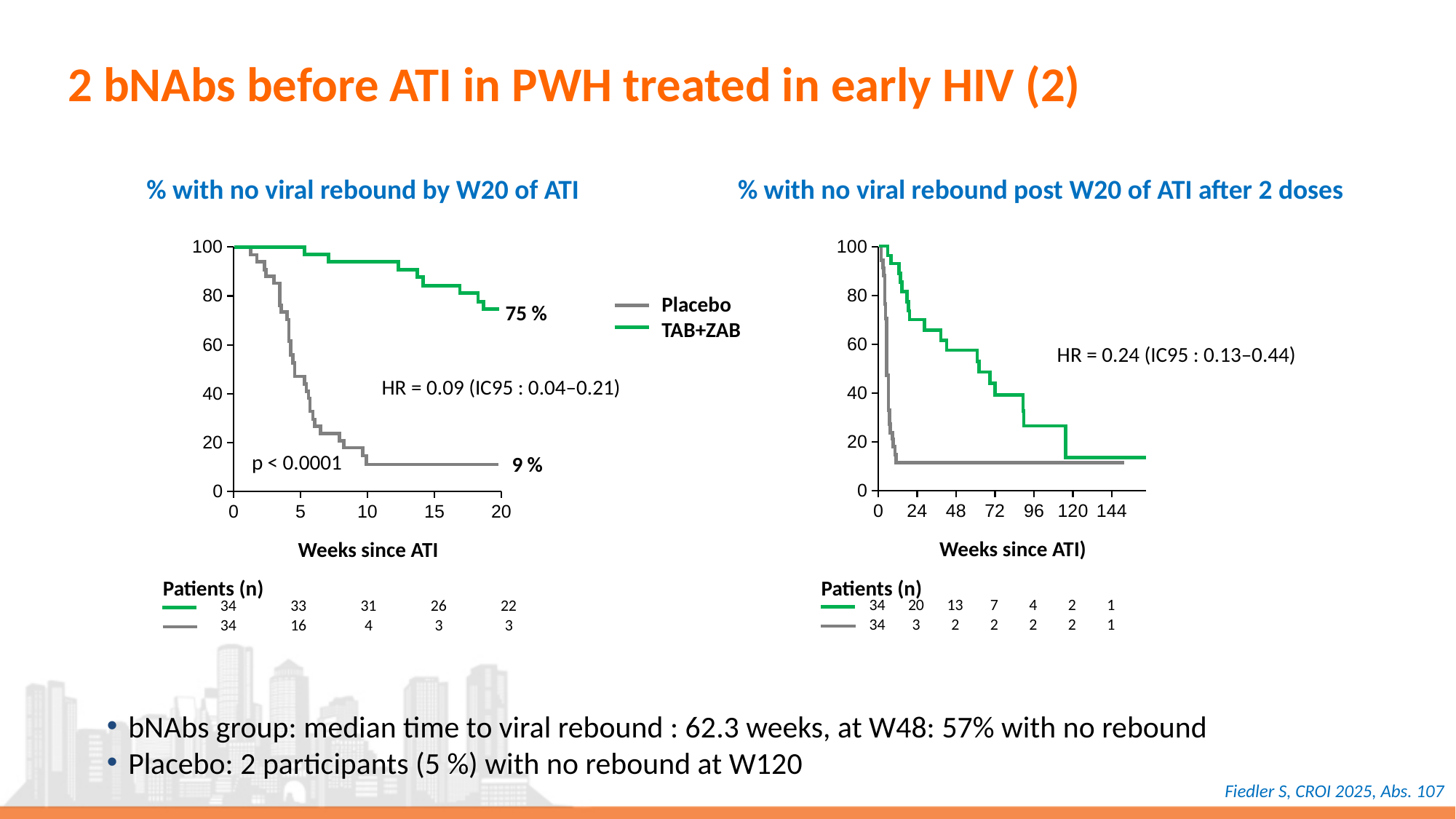
In the right chart (% with no viral rebound post W20 of ATI after 2 doses), is the Placebo value at week 24 greater or less than 20? less In the left chart (% with no viral rebound by W20 of ATI), which group has the higher percentage with no viral rebound at week 20? TAB+ZAB In the left chart (% with no viral rebound by W20 of ATI), what percentage of the Placebo group had no viral rebound at week 20? 9 % In the right chart (% with no viral rebound post W20 of ATI after 2 doses), is the TAB+ZAB value at week 48 greater or less than 40? greater What kind of chart is the left chart (% with no viral rebound by W20 of ATI)? line chart In the left chart (% with no viral rebound by W20 of ATI), what hazard ratio is printed on the chart? HR = 0.09 (IC95 : 0.04–0.21) How many series does the legend of the left chart list? 2 In the left chart (% with no viral rebound by W20 of ATI), how many Placebo patients are listed at risk at week 10 in the Patients (n) table? 4 In the left chart (% with no viral rebound by W20 of ATI), what percentage of the TAB+ZAB group had no viral rebound at week 20? 75 % In the left chart (% with no viral rebound by W20 of ATI), does the Placebo curve rise or fall as weeks since ATI increase? fall In the right chart (% with no viral rebound post W20 of ATI after 2 doses), what hazard ratio is printed on the chart? HR = 0.24 (IC95 : 0.13–0.44) In the left chart (% with no viral rebound by W20 of ATI), what is the difference between the TAB+ZAB and Placebo percentages labelled at week 20? 66 %